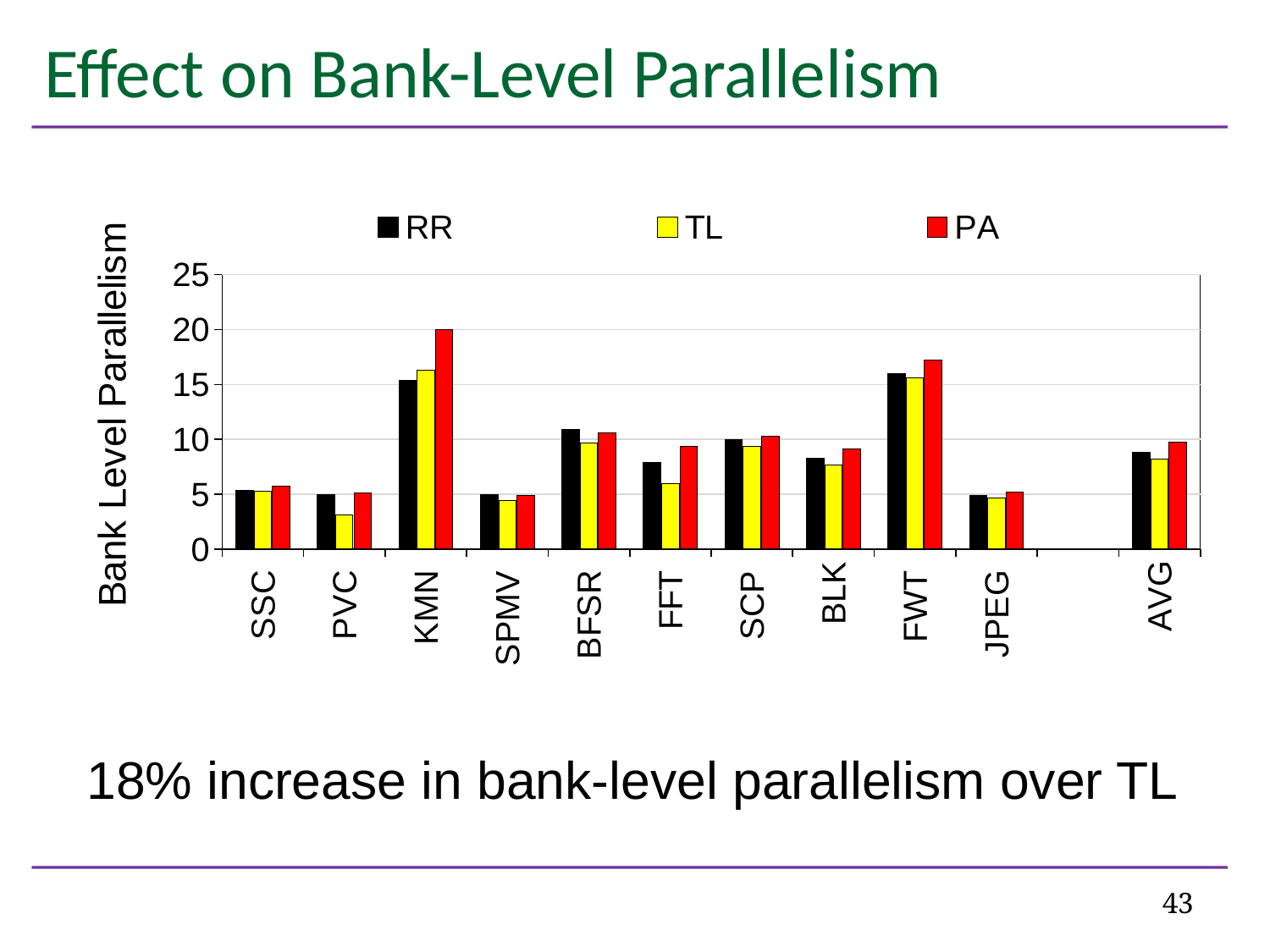
How many series does the legend list? 3 Which category has the highest PA value? KMN Which is larger, the PA value for KMN or the PA value for FWT? KMN Is the RR value for FWT greater or less than 15? greater For FFT, which is larger, the RR value or the TL value? RR Is the TL value for PVC greater or less than 5? less Is the TL value for FFT greater or less than 10? less What is the label of the y axis? Bank Level Parallelism How many categories are shown along the x axis? 11 Which category has the lowest TL value? PVC What kind of chart is shown on the slide? bar chart